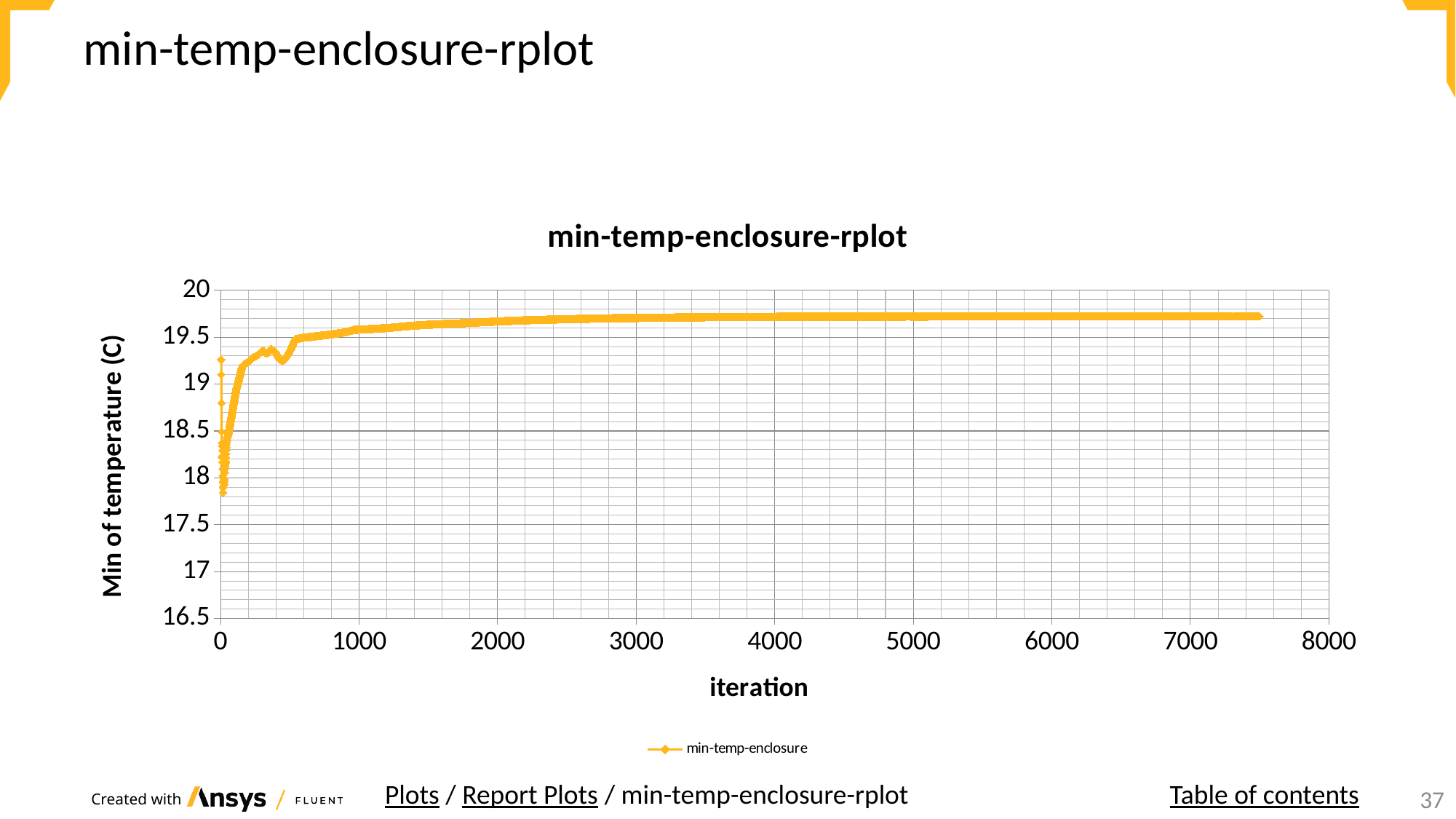
Near which end of the x axis does the lowest value of min-temp-enclosure occur, near iteration 0 or near iteration 7500? near iteration 0 What is the title of the chart? min-temp-enclosure-rplot Overall, do the values rise or fall as the iteration increases along the x axis? rise Is the lowest value of min-temp-enclosure greater or less than 18? less What is the label of the y axis? Min of temperature (C) Is the value for min-temp-enclosure at iteration 2000 greater or less than 19.5? greater What kind of chart is shown on the slide? line chart How many series does the legend list? 1 Is the value for min-temp-enclosure at iteration 7000 greater or less than 19? greater Which is larger, the value of min-temp-enclosure at iteration 100 or at iteration 5000? iteration 5000